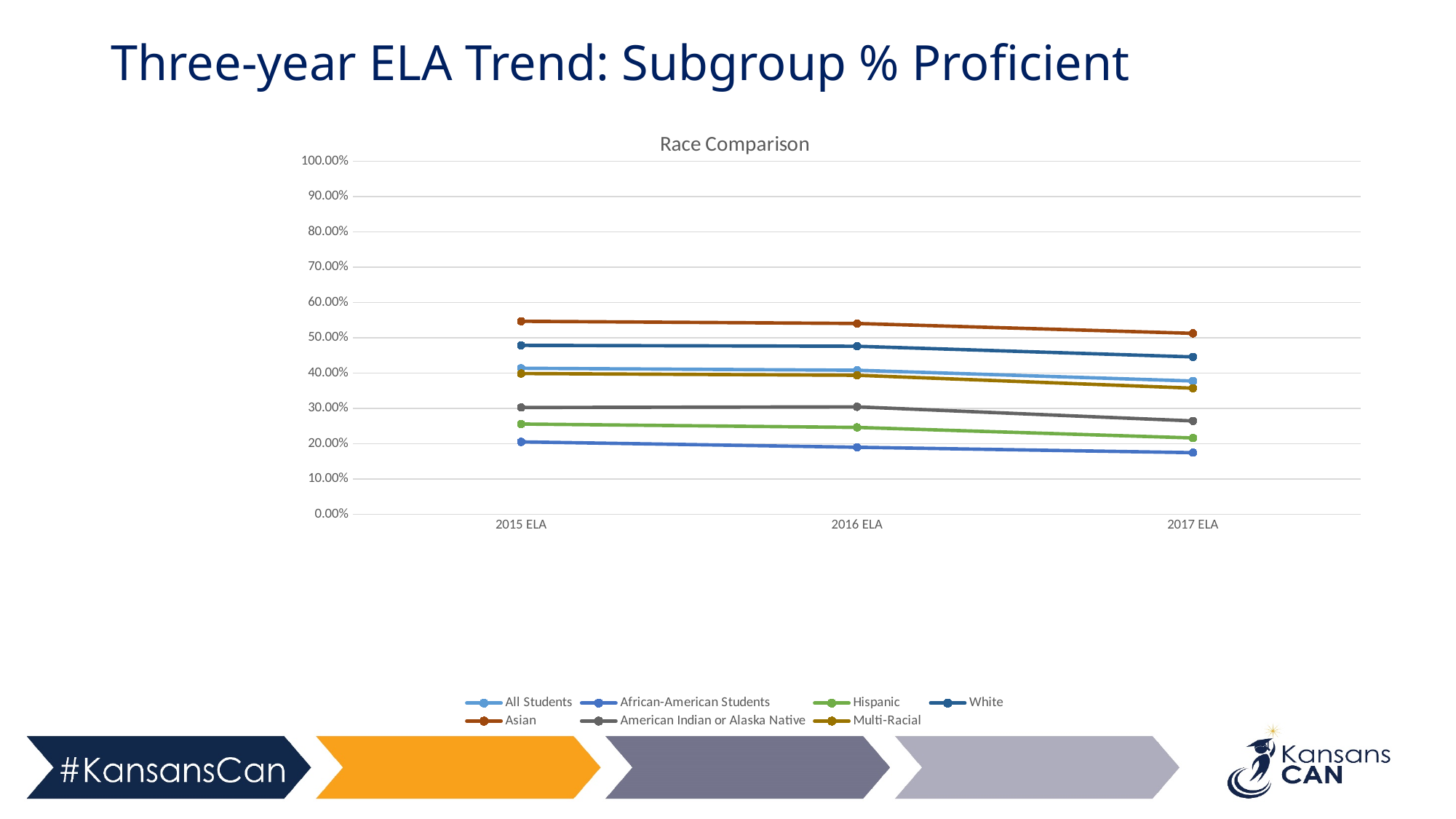
Which is larger in 2016 ELA, the value for White or the value for Hispanic? White How many points along the x axis does each line have? 3 Which subgroup has the highest % proficient in 2017 ELA? Asian What kind of chart is shown on the slide? Line chart Is the value for African-American Students in 2017 ELA greater or less than 20.00%? less Which subgroup has the lowest % proficient in 2015 ELA? African-American Students Does the Asian line rise or fall from 2015 ELA to 2017 ELA? Fall Is the value for Asian in 2015 ELA greater or less than 50.00%? greater What is the title printed above the chart? Race Comparison How many series does the legend list? 7 Is the value for American Indian or Alaska Native in 2017 ELA greater or less than 30.00%? less